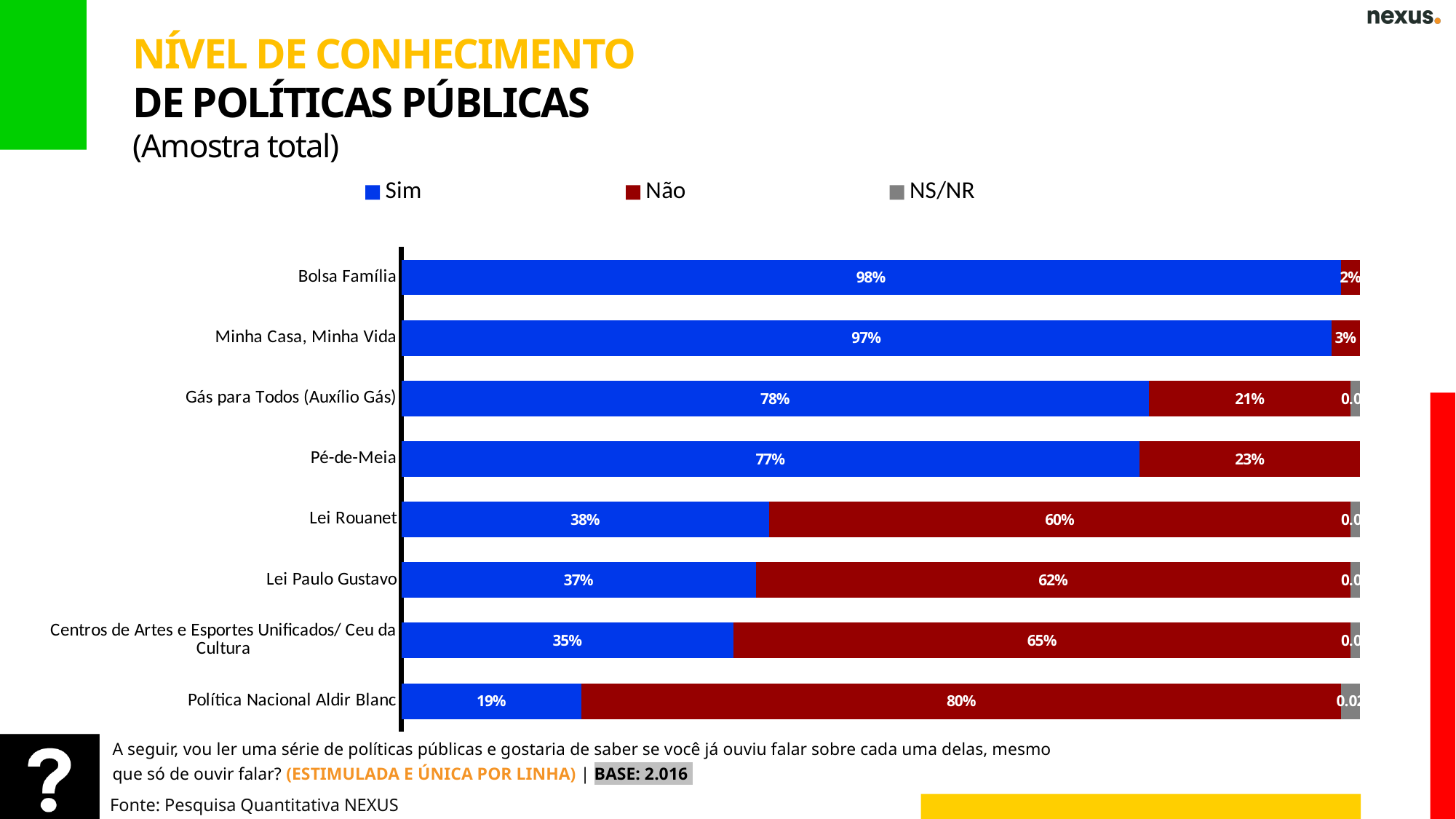
How many policies are listed in the chart? 8 Which is larger for Pé-de-Meia: the "Sim" value or the "Não" value? Sim Which colour represents the "Não" series in the chart? Dark red What percentage of respondents answered "Sim" for Bolsa Família? 98% What is the "Não" value for Política Nacional Aldir Blanc? 80% What is the "Não" value for Gás para Todos (Auxílio Gás)? 21% What is the difference between the "Não" and "Sim" values for Centros de Artes e Esportes Unificados/ Ceu da Cultura? 30% Which policy has the lowest "Sim" percentage? Política Nacional Aldir Blanc What type of chart is shown on the slide? Stacked bar chart What is the "Sim" value for Lei Rouanet? 38% How many series does the legend list? 3 Which policy has the highest "Sim" percentage? Bolsa Família